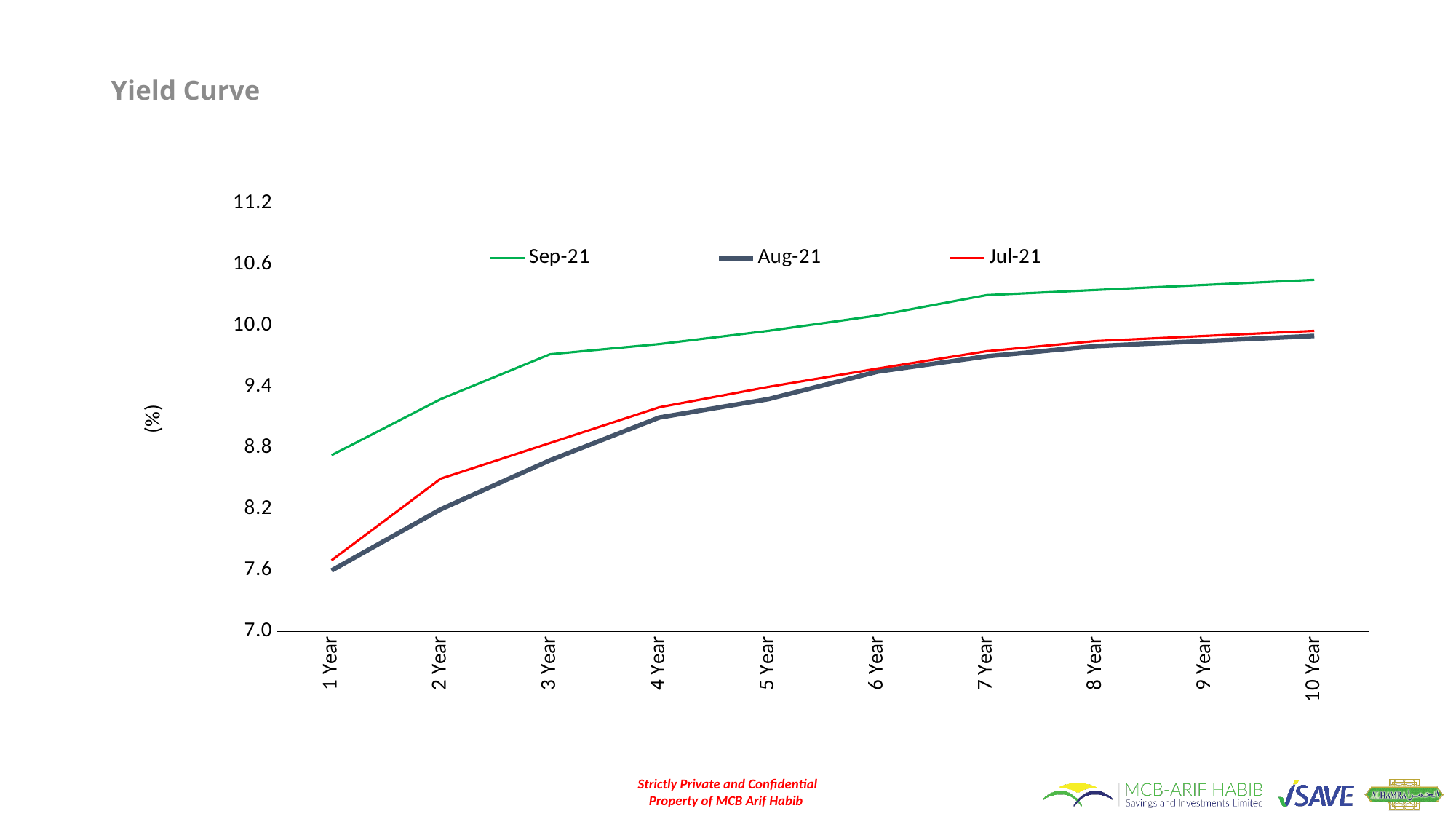
Is the Sep-21 value at 10 Year greater or less than 10.0? greater At 2 Year, which is higher: Jul-21 or Aug-21? Jul-21 Is the Aug-21 value at 4 Year greater or less than 9.4? less Do the Sep-21 yields rise or fall as maturity increases from 1 Year to 10 Year? rise What colour is the Sep-21 line? green Which series has the highest yield at 10 Year? Sep-21 What is the title of the chart? Yield Curve How many series does the legend list? 3 At 3 Year, which is higher: Sep-21 or Jul-21? Sep-21 Which series has the lowest yield at 1 Year? Aug-21 How many maturity points are shown along the x axis? 10 What kind of chart is shown on the slide? line chart